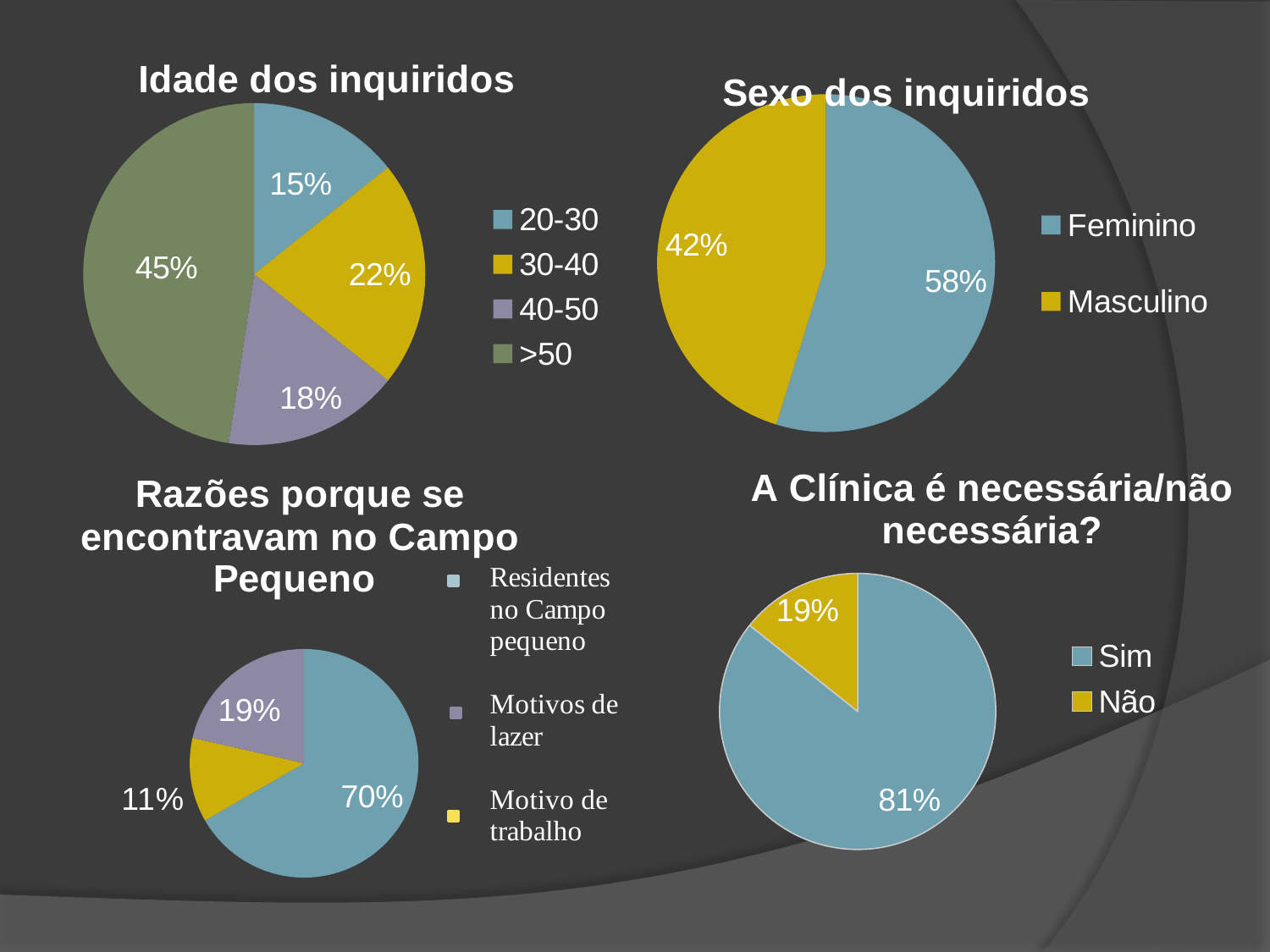
In the 'Razões porque se encontravam no Campo Pequeno' chart, which category has the largest share? Residentes no Campo pequeno In the 'Sexo dos inquiridos' chart, what share of respondents are Masculino? 42% In the 'Razões porque se encontravam no Campo Pequeno' chart, what share is 'Motivo de trabalho'? 11% In the 'Sexo dos inquiridos' chart, which is larger, Feminino or Masculino? Feminino In the 'Idade dos inquiridos' chart, what share of respondents are aged >50? 45% In the 'Idade dos inquiridos' chart, which age group has the smallest share? 20-30 In the 'Idade dos inquiridos' chart, what is the difference between the 30-40 and 40-50 shares? 4% In the 'Razões porque se encontravam no Campo Pequeno' chart, what is the difference between 'Residentes no Campo pequeno' and 'Motivos de lazer'? 51% What kind of chart is 'Sexo dos inquiridos'? Pie chart How many entries does the legend of the 'A Clínica é necessária/não necessária?' chart list? 2 How many categories does the 'Idade dos inquiridos' chart show? 4 In the 'A Clínica é necessária/não necessária?' chart, what share answered Sim? 81%